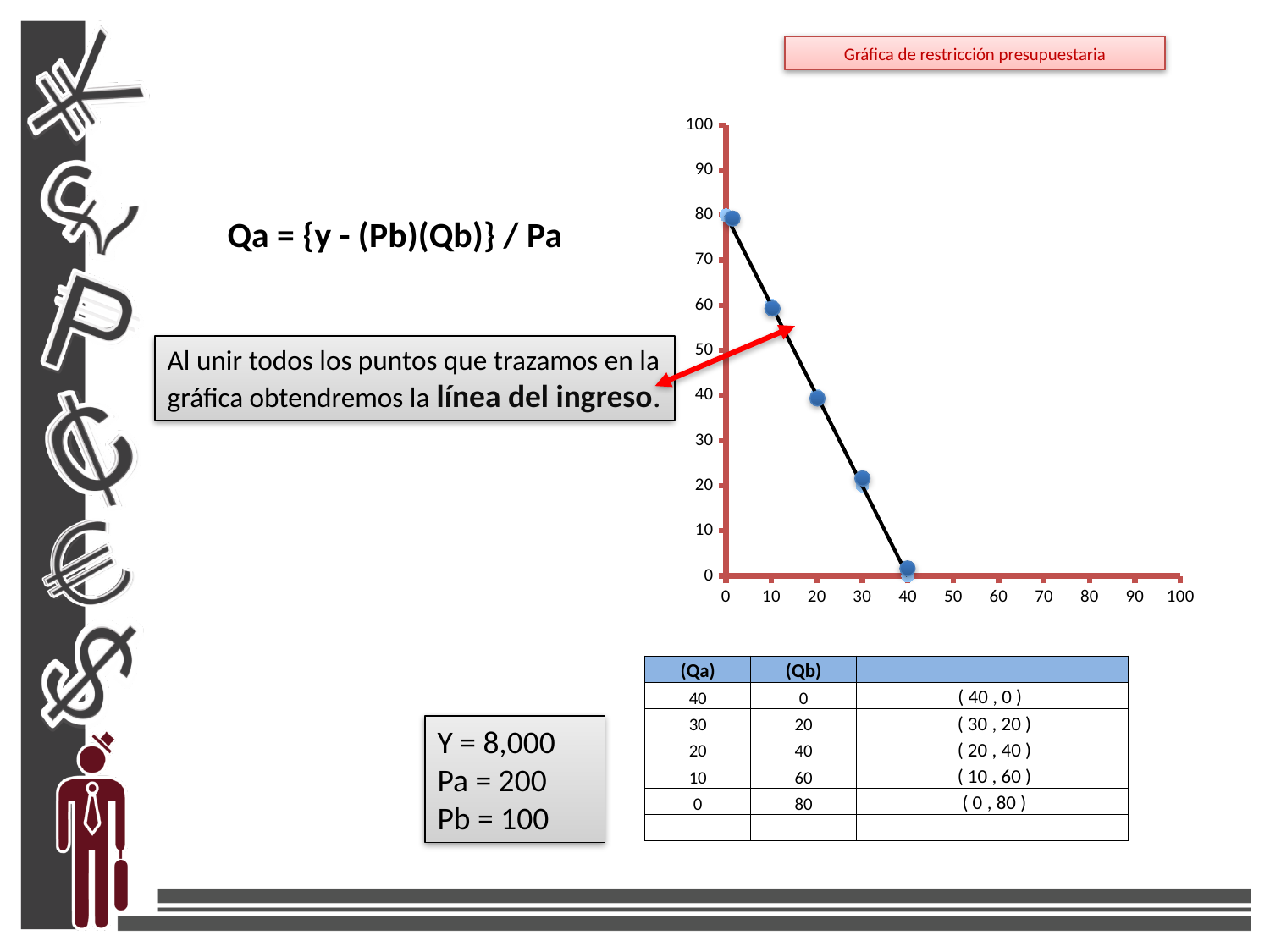
How many data points are plotted on the chart? 5 What is the difference between the y values at x = 10 and x = 30? 40 What is the y value of the point plotted at x = 0? 80 What is the y value of the point plotted at x = 40? 0 As the x-axis value increases, do the plotted values rise or fall? fall What kind of chart is shown on the slide? line chart What is the title shown above the chart? Gráfica de restricción presupuestaria Which has the larger y value: the point at x = 10 or the point at x = 30? the point at x = 10 What is the y value of the point plotted at x = 20? 40 Is the y value of the point at x = 10 greater or less than 50? greater At which x value does the chart reach its highest y value? 0 At which x value does the chart reach its lowest y value? 40